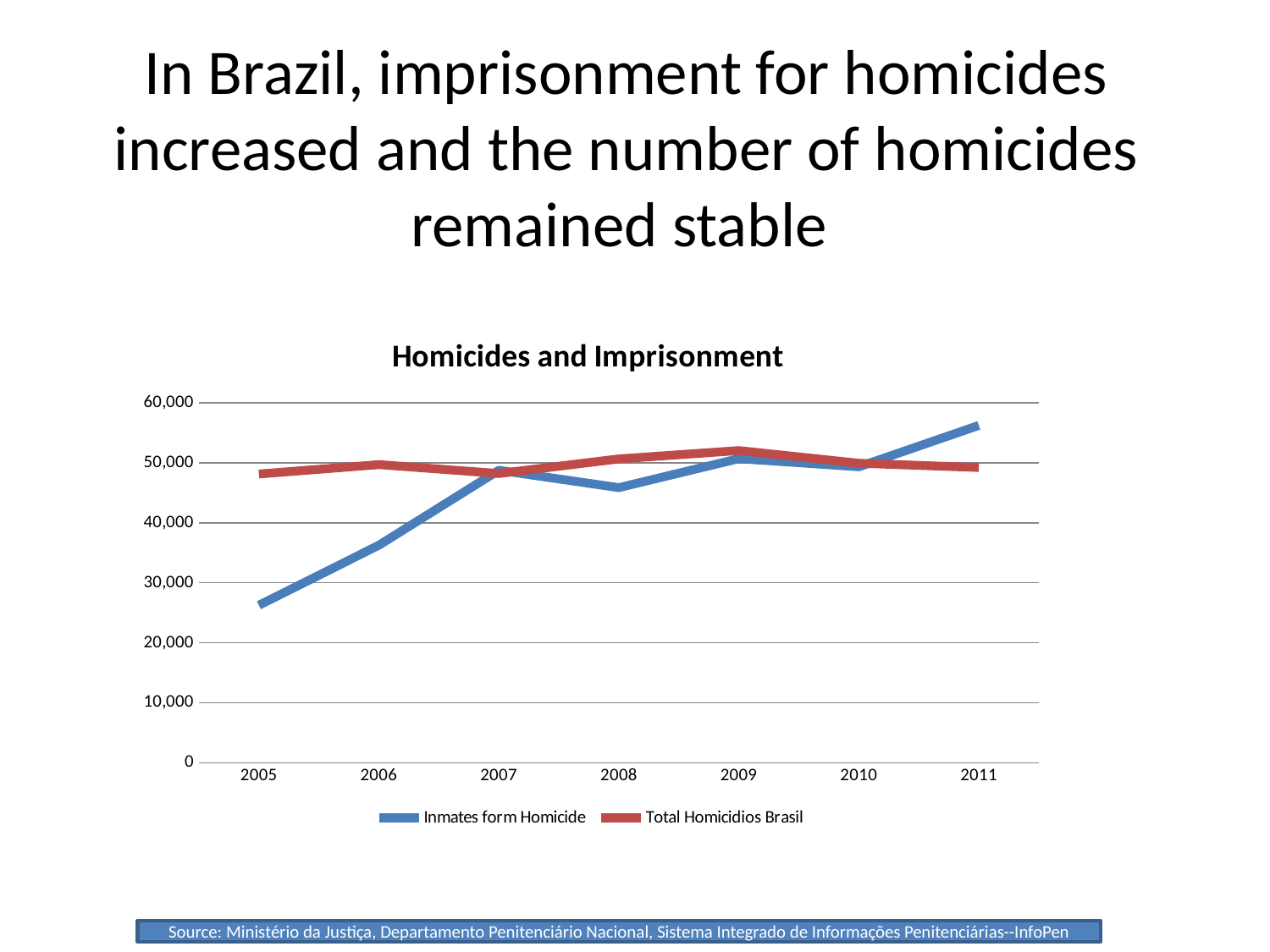
Is the value for Inmates form Homicide in 2005 greater or less than 30,000? less How many years are shown on the x axis? 7 Is the value for Inmates form Homicide in 2011 greater or less than 50,000? greater What kind of chart is shown on the slide? line chart How many series does the legend list? 2 Is the value for Total Homicidios Brasil in 2005 greater or less than 50,000? less In which year is the value for Inmates form Homicide highest? 2011 What is the title of the chart? Homicides and Imprisonment In 2005, which series has the larger value, Inmates form Homicide or Total Homicidios Brasil? Total Homicidios Brasil In 2011, which series has the larger value, Inmates form Homicide or Total Homicidios Brasil? Inmates form Homicide Does the Inmates form Homicide series rise or fall overall from 2005 to 2011? rise In which year is the value for Inmates form Homicide lowest? 2005